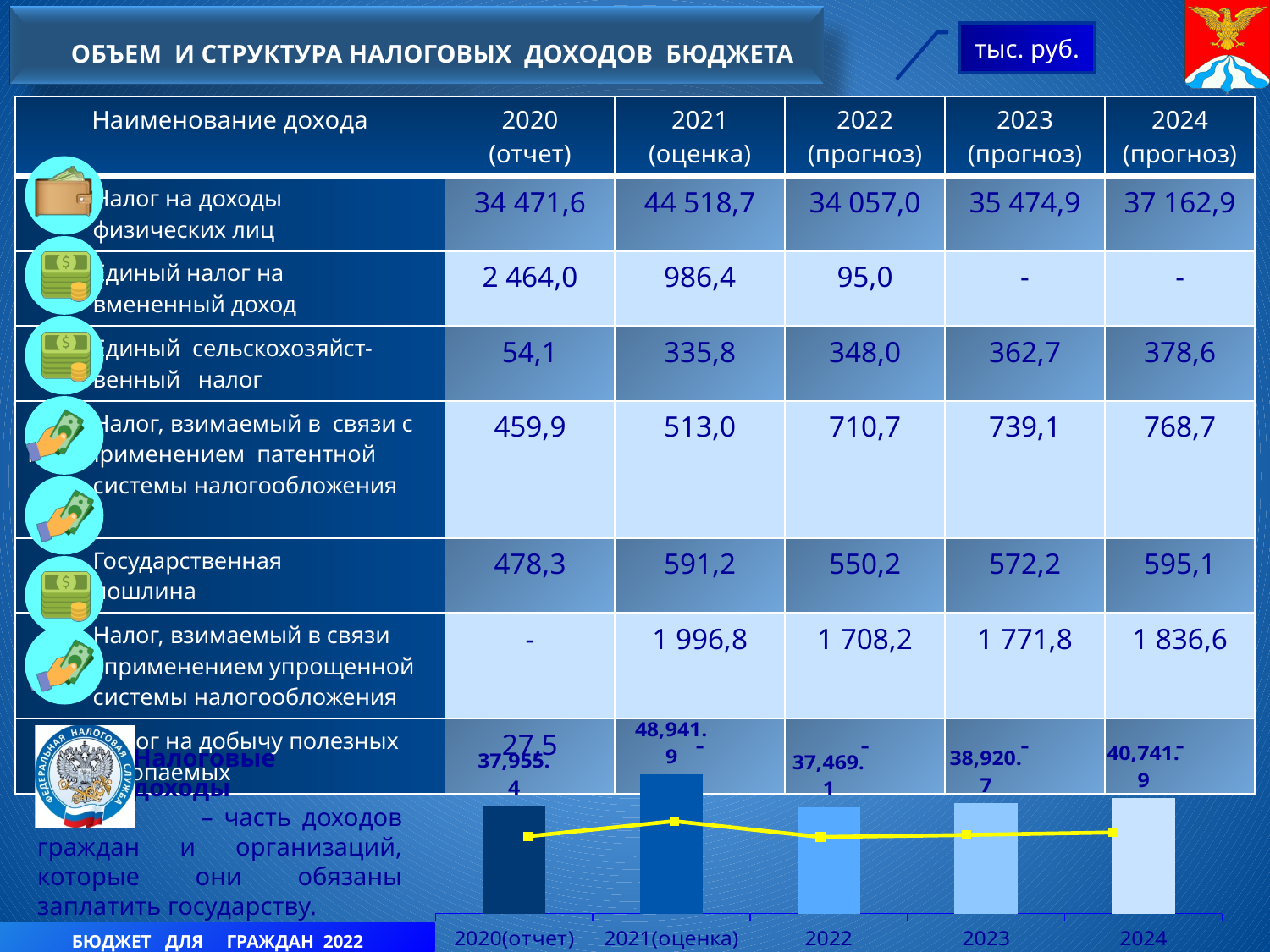
In the bar chart at the bottom of the slide, what is the difference between the 2024 value and the 2022 value? 3,272.8 What is the value shown for 2024 in the bar chart at the bottom of the slide? 40,741.9 Which year has the highest value in the bar chart at the bottom of the slide? 2021(оценка) How many years (categories) are plotted in the bar chart at the bottom of the slide? 5 In the bar chart at the bottom of the slide, what is the difference between the 2021(оценка) value and the 2020(отчет) value? 10,986.5 What kind of chart is shown at the bottom of the slide? Bar chart with a line overlay Which year has the lowest value in the bar chart at the bottom of the slide? 2022 In the bar chart at the bottom of the slide, which is larger: the value for 2023 or the value for 2020(отчет)? 2023 In the bar chart at the bottom of the slide, do the values rise or fall from 2022 to 2024? Rise What is the value shown for 2020(отчет) in the bar chart at the bottom of the slide? 37,955.4 What is the value shown for 2021(оценка) in the bar chart at the bottom of the slide? 48,941.9 What is the value shown for 2022 in the bar chart at the bottom of the slide? 37,469.1